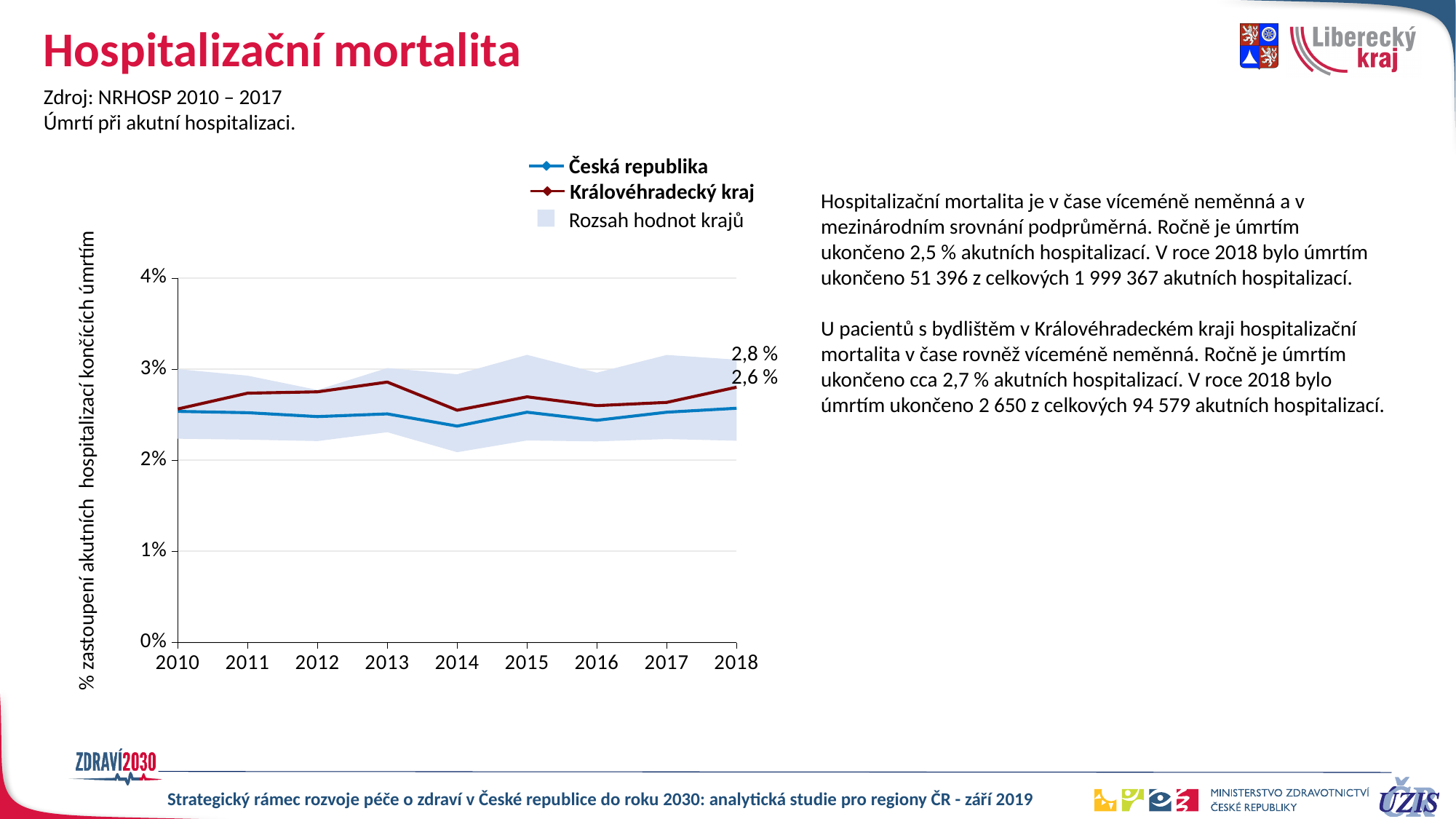
Is the value for Královéhradecký kraj in 2013 greater or less than 3%? less In 2018, which series has the higher value: Česká republika or Královéhradecký kraj? Královéhradecký kraj What is the difference between the 2018 values for Královéhradecký kraj and Česká republika? 0,2 % How many entries does the chart legend list? 3 Between 2013 and 2014, did the value for Královéhradecký kraj rise or fall? fall What does the shaded area in the chart represent, according to the legend? Rozsah hodnot krajů What kind of chart is shown on the slide? Line chart How many years are shown on the x axis of the chart? 9 What is the title of the slide containing the chart? Hospitalizační mortalita What is the value for Česká republika in 2018? 2,6 % Is the value for Česká republika in 2014 greater or less than 2%? greater What is the value for Královéhradecký kraj in 2018? 2,8 %